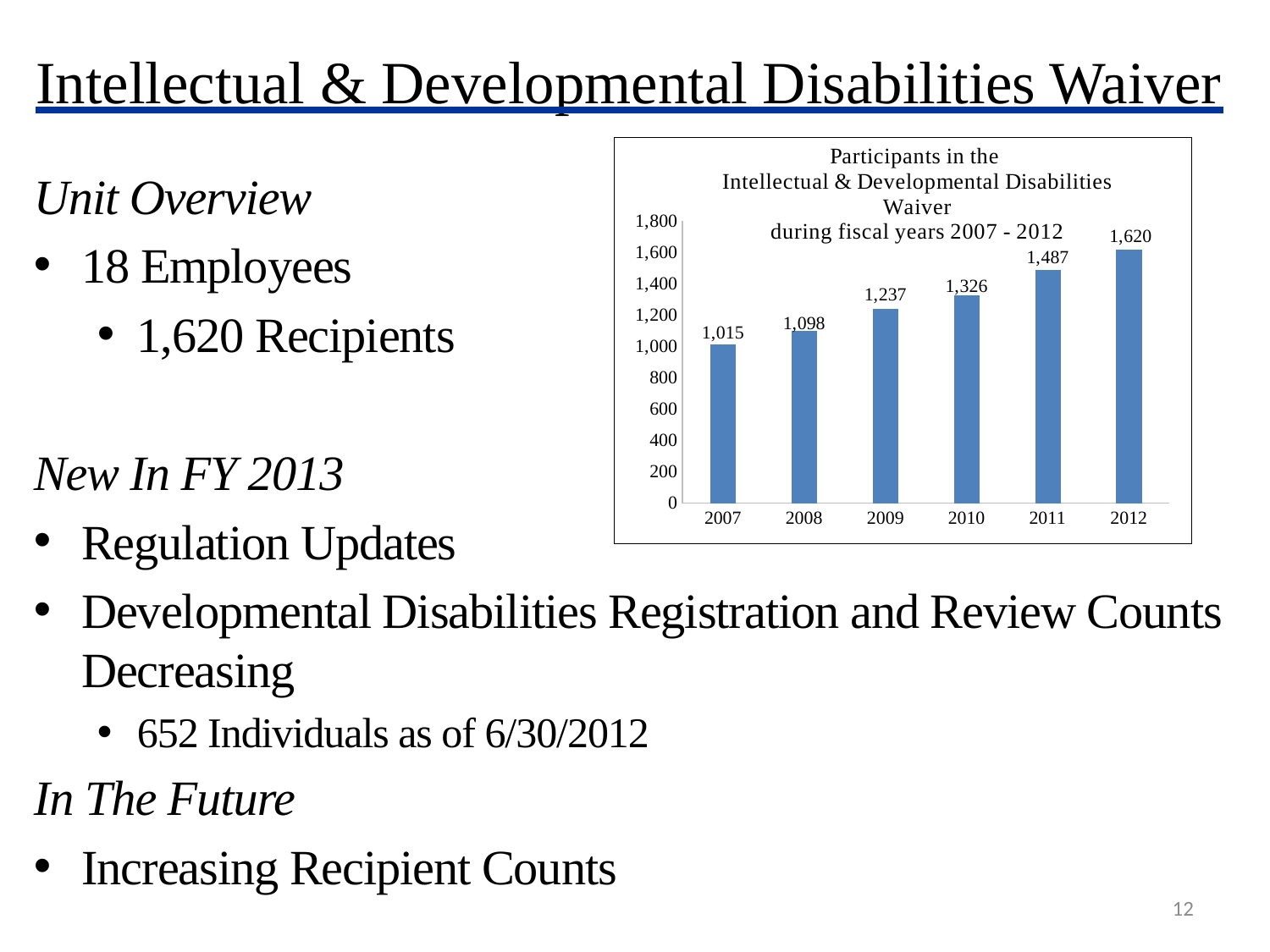
Which year has the lowest number of participants? 2007 What is the number of participants in 2007? 1,015 What is the difference in participants between 2012 and 2007? 605 Is the value for 2008 greater or less than 1,200? less Which year has the highest number of participants? 2012 Do the participant counts rise or fall from 2007 to 2012? rise What is the number of participants in 2012? 1,620 What is the number of participants in 2010? 1,326 Which year has more participants, 2009 or 2011? 2011 What is the difference in participants between 2011 and 2010? 161 How many fiscal years are shown on the x axis? 6 What kind of chart is shown on the slide? bar chart